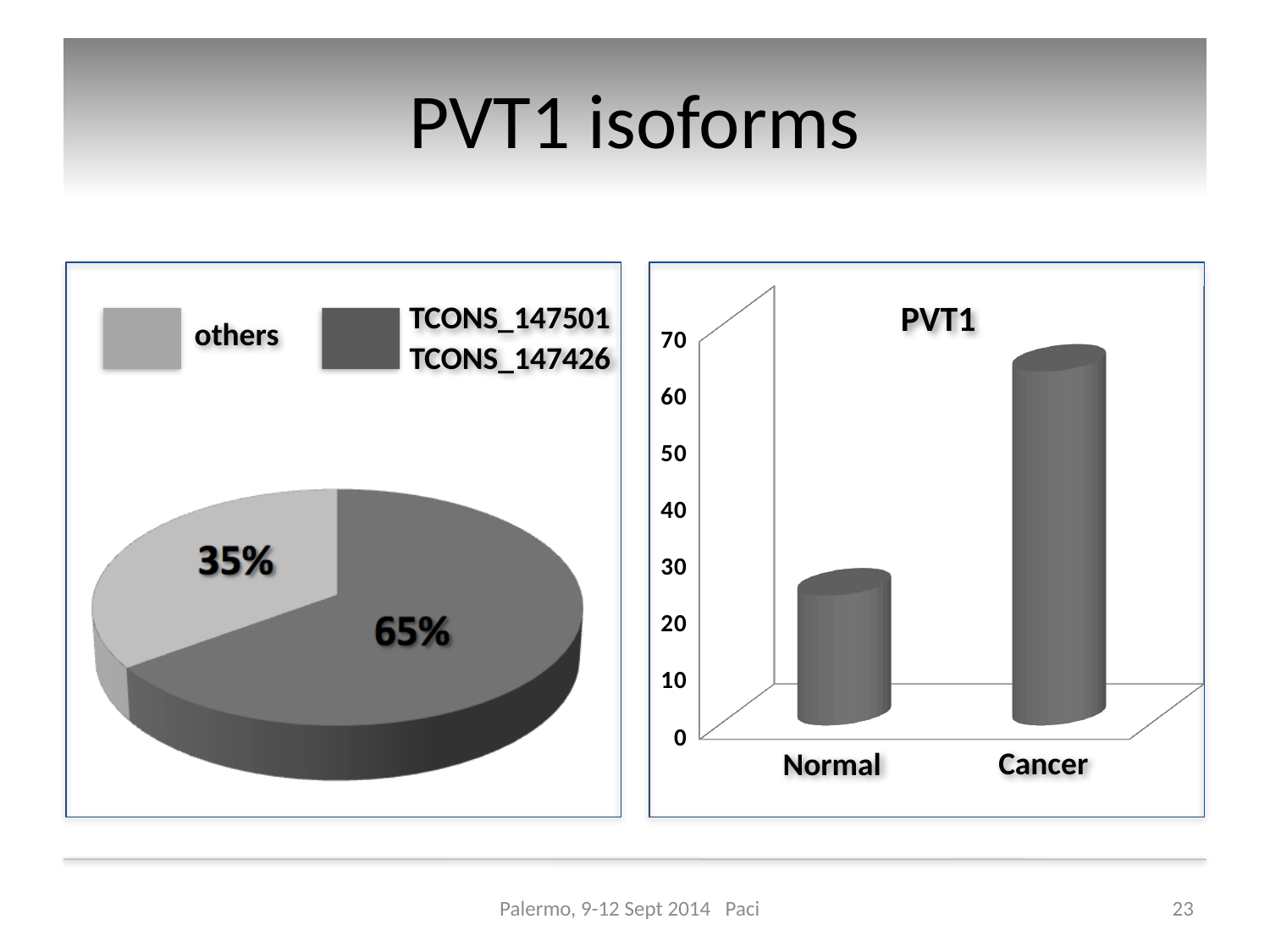
What kind of chart is the chart titled PVT1 on the right of the slide? bar chart What kind of chart is the chart on the left of the slide? pie chart In the pie chart on the left, what is the difference in percentage points between the two slices? 30 In the pie chart on the left, what share does the TCONS_147501 / TCONS_147426 slice have? 65% In the PVT1 bar chart on the right, is the value for Normal greater or less than 40? less In the pie chart on the left, which slice is larger: 'others' or TCONS_147501 / TCONS_147426? TCONS_147501 / TCONS_147426 In the pie chart on the left, how many slices are there? 2 In the PVT1 bar chart on the right, is the value for Cancer greater or less than 50? greater In the PVT1 bar chart on the right, which category has the highest value? Cancer In the PVT1 bar chart on the right, which category has the lowest value? Normal In the pie chart on the left, what share does the 'others' slice have? 35% In the pie chart on the left, how many entries does the legend list? 2